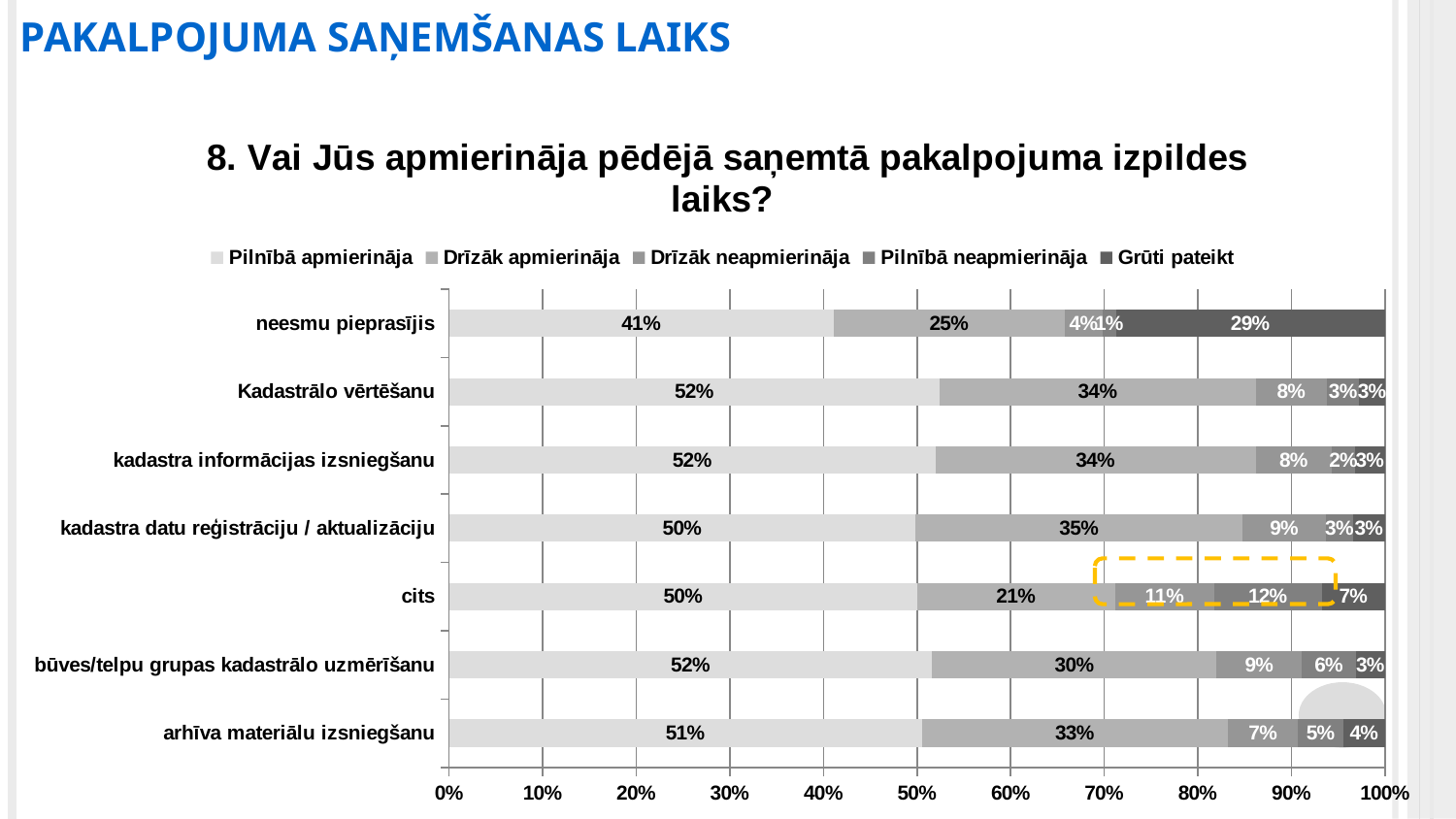
What is the total of the stacked bar for 'neesmu pieprasījis'? 100% What type of chart is shown on the slide? Stacked bar chart What is the difference between the 'Drīzāk apmierināja' values for 'Kadastrālo vērtēšanu' and 'cits'? 13% What is the 'Pilnībā neapmierināja' value for 'cits'? 12% What is the 'Grūti pateikt' value for 'neesmu pieprasījis'? 29% What is the 'Drīzāk apmierināja' value for 'būves/telpu grupas kadastrālo uzmērīšanu'? 30% Which category has the lowest 'Pilnībā apmierināja' share? neesmu pieprasījis How many categories are shown on the vertical axis? 7 What percentage of respondents for 'cits' answered 'Pilnībā apmierināja'? 50% Which is larger: the 'Drīzāk neapmierināja' value for 'cits' or for 'arhīva materiālu izsniegšanu'? cits Which category has the highest 'Grūti pateikt' share? neesmu pieprasījis How many series does the legend list? 5